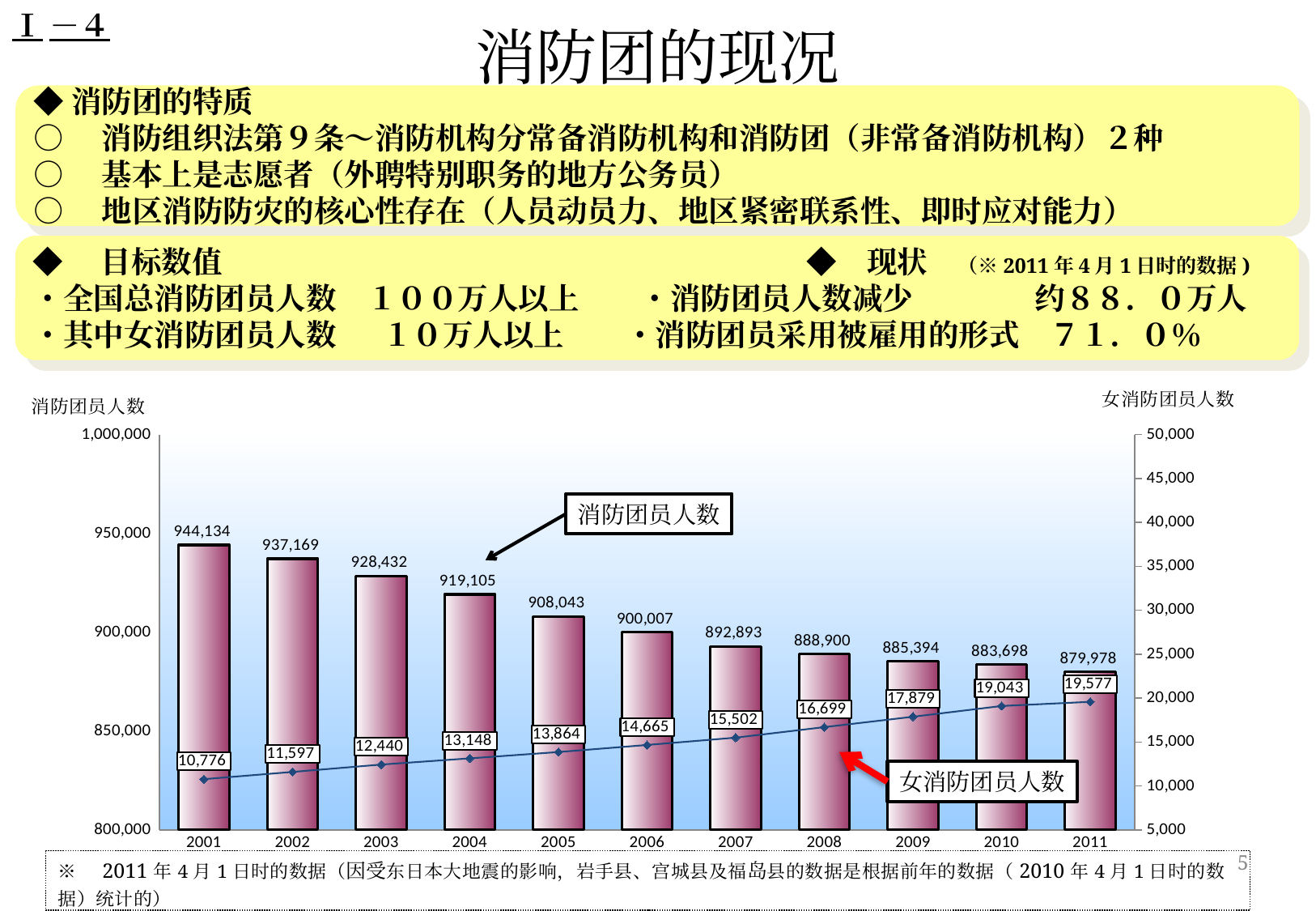
What is the value of 女消防团员人数 for 2005? 13,864 What is the difference in 消防团员人数 between 2001 and 2011? 64,156 What is the value of 消防团员人数 for 2006? 900,007 How many years are shown on the x axis of the chart? 11 Which year has the highest 消防团员人数? 2001 How does 女消防团员人数 change from 2001 to 2011? It rises What is the value of 女消防团员人数 for 2011? 19,577 What is the value of 消防团员人数 for 2001? 944,134 What is the difference in 女消防团员人数 between 2010 and 2009? 1,164 How does 消防团员人数 change from 2001 to 2011? It falls Which is larger, the 消防团员人数 for 2004 or for 2008? 2004 Which year has the lowest 女消防团员人数? 2001